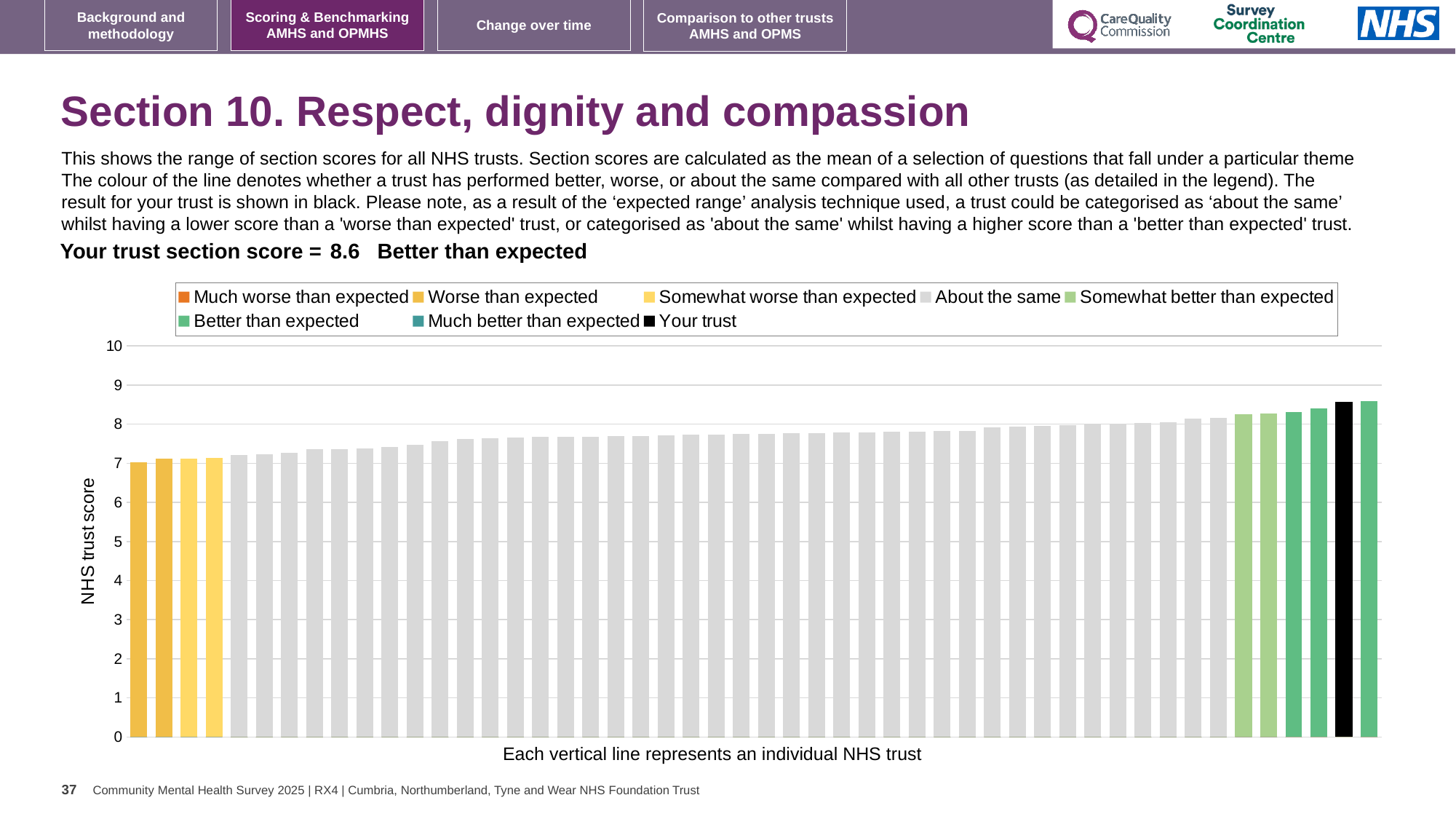
Which is larger: the black bar for your trust or the leftmost bar? the black bar for your trust Do the bar values rise or fall from left to right along the x axis? rise Is the value of the leftmost bar greater or less than 8? less How many entries does the chart legend list? 8 Is the value of the tallest bar greater or less than 9? less What is the section score for your trust shown on the slide? 8.6 Is the value of the leftmost bar greater or less than 6? greater What colour is used for the bar representing your trust? black What is the label on the vertical axis of the chart? NHS trust score What kind of chart is shown on the slide? bar chart Which category is your trust's section score placed in? Better than expected